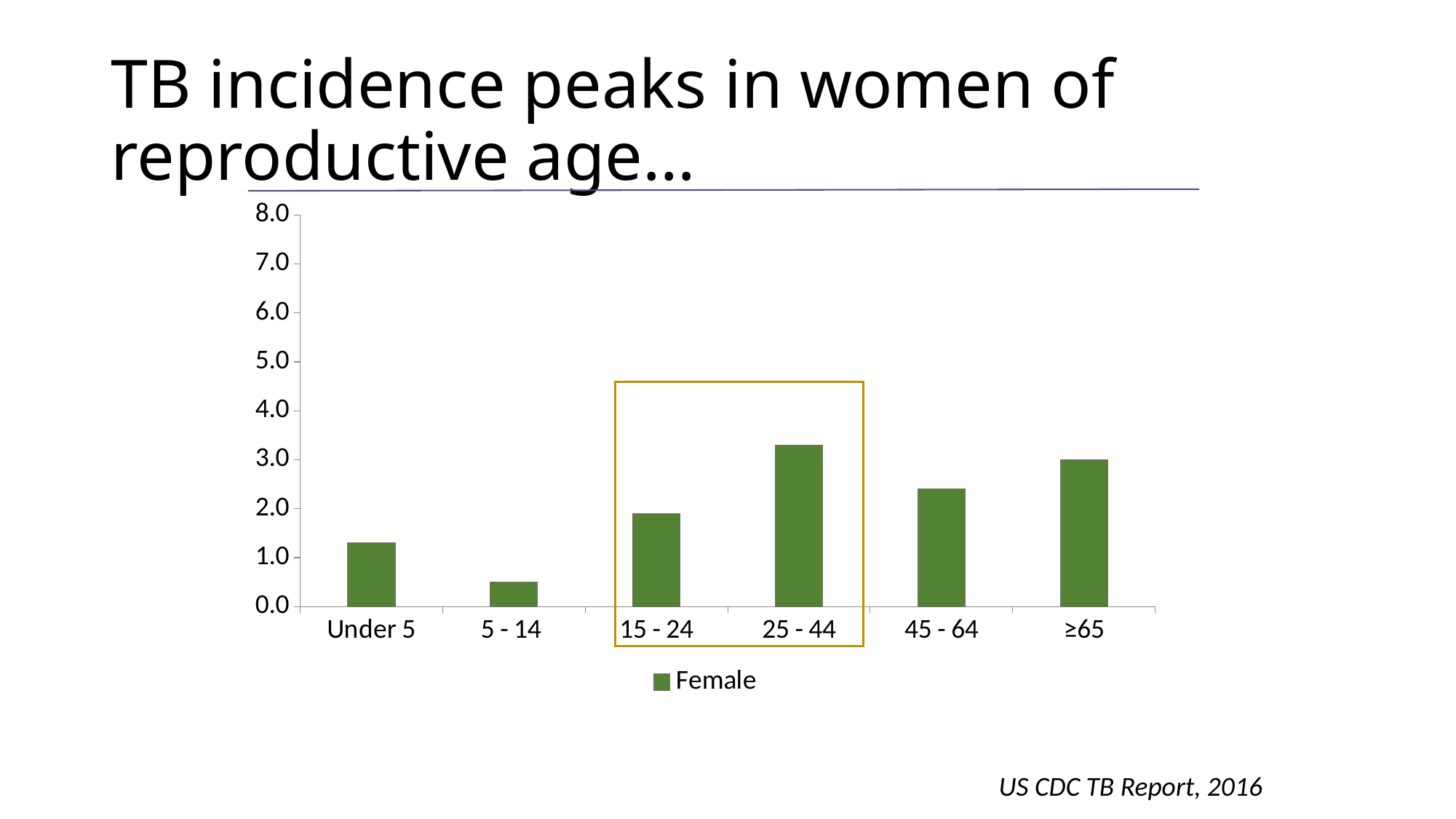
How many age categories are shown on the x axis of the chart? 6 Which age group has the lowest value in the chart? 5 - 14 What kind of chart is shown on the slide? bar chart What is the name of the series shown in the chart's legend? Female Which has the larger value, the 25 - 44 age group or the 45 - 64 age group? 25 - 44 Is the value for the 25 - 44 age group greater or less than 3.0? greater How many series does the chart's legend list? 1 Which two age groups are enclosed by the highlighted box on the chart? 15 - 24 and 25 - 44 Is the value for the 5 - 14 age group greater or less than 1.0? less Which has the larger value, the Under 5 age group or the 15 - 24 age group? 15 - 24 Which age group has the highest value in the chart? 25 - 44